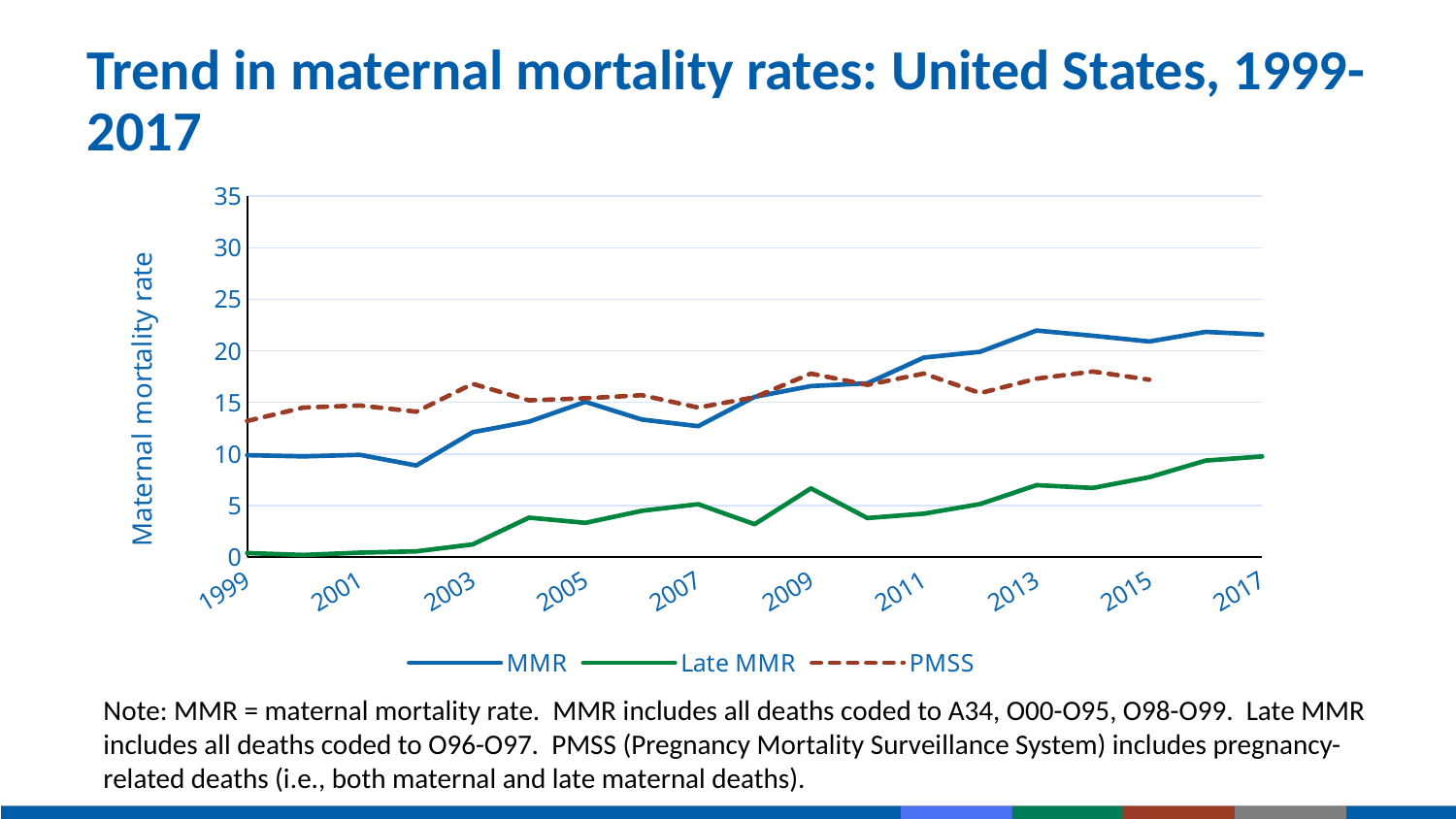
What kind of chart is shown on the slide? Line chart In 2003, which is larger, PMSS or MMR? PMSS Is the MMR value for 2013 greater or less than 20? greater Is the PMSS value for 2003 greater or less than 15? greater Is the MMR value for 2017 greater or less than 20? greater Which series has the lowest values across all years shown? Late MMR How many series does the legend list? 3 In 2017, which is larger, MMR or Late MMR? MMR Which series is drawn with a dashed line? PMSS What is the label of the y axis? Maternal mortality rate Does the MMR series generally rise or fall from 1999 to 2017? Rise